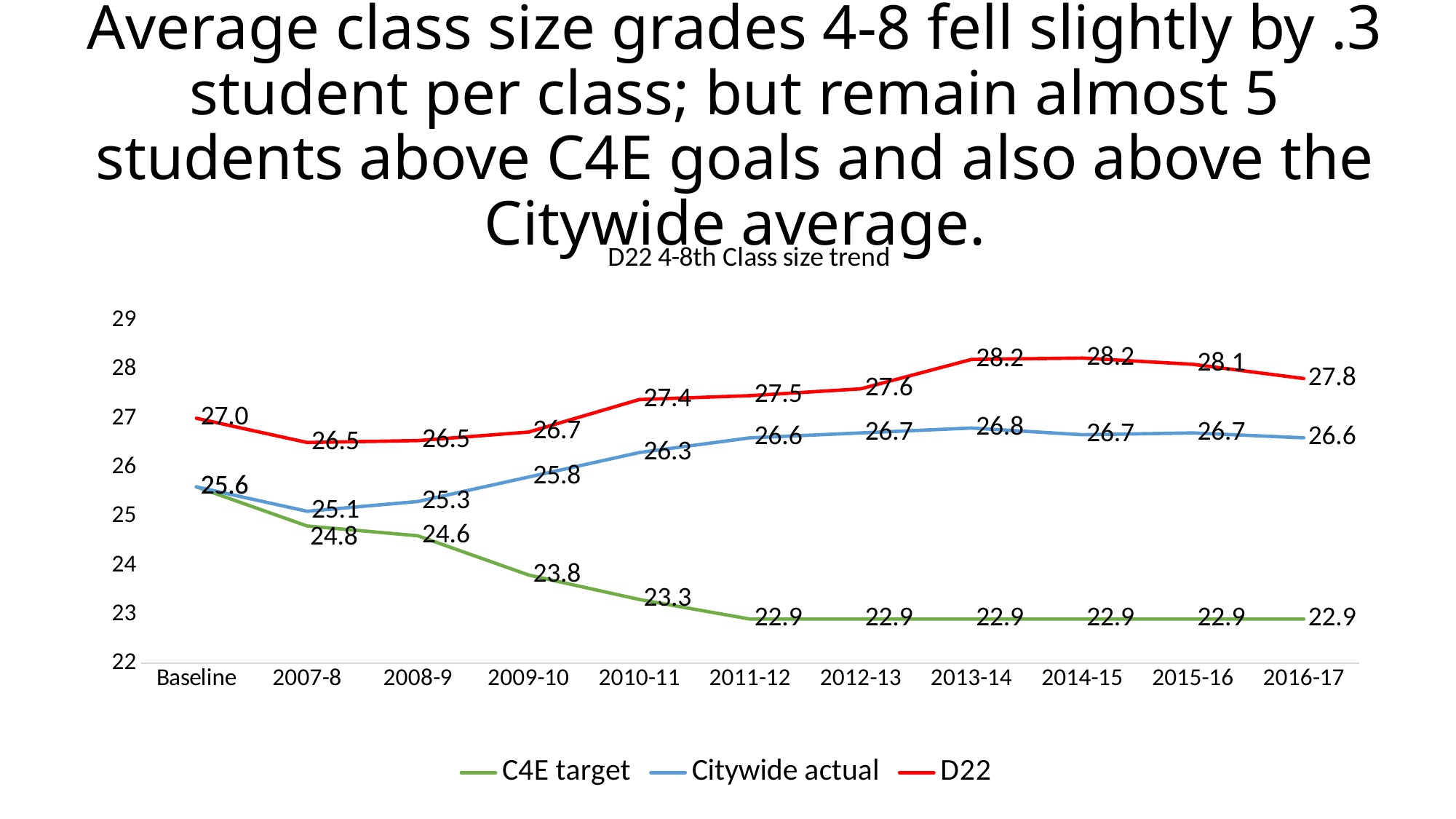
What is the Citywide actual value for 2010-11? 26.3 How many series does the legend list? 3 Which series has the larger value in 2013-14, D22 or Citywide actual? D22 In which year does the D22 series reach its lowest value? 2007-8 and 2008-9 (26.5) What is the difference between the D22 value and the C4E target value in 2016-17? 4.9 What is the highest value of the Citywide actual series? 26.8 What is the D22 value for 2016-17? 27.8 What type of chart is shown on the slide? line chart How many points are plotted along the x axis for each series? 11 What is the C4E target value for 2009-10? 23.8 Does the C4E target series rise or fall from Baseline to 2011-12? fall What is the title of the chart? D22 4-8th Class size trend